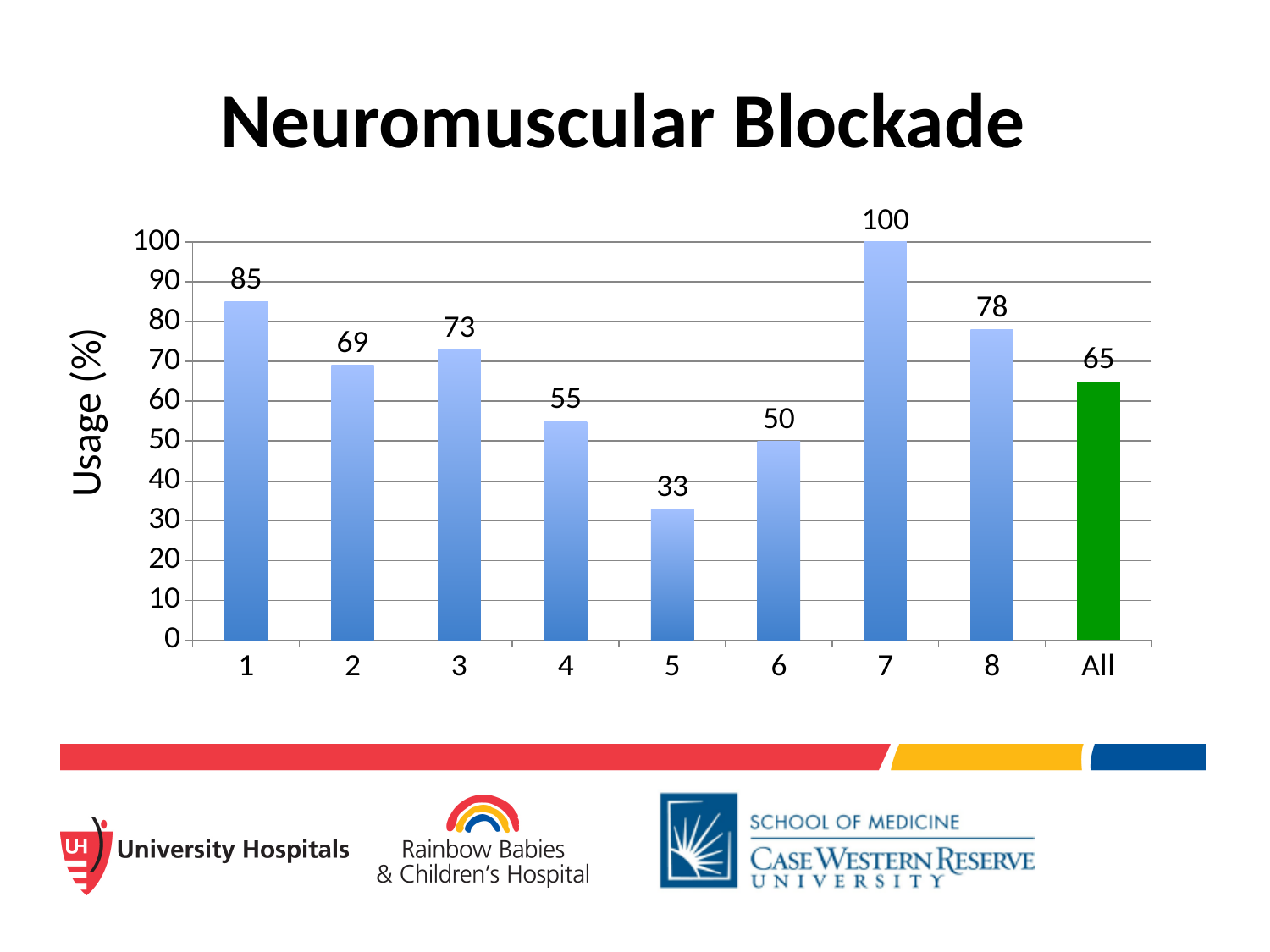
What is the difference in usage (%) between category 1 and category 4? 30 How many categories are shown on the x axis? 9 What is the difference in usage (%) between category 7 and category 8? 22 Which category has the highest usage (%)? 7 What is the usage (%) value for category 5? 33 Which has a higher usage (%), category 2 or category 3? 3 What is the usage (%) value for category 1? 85 Which category has the lowest usage (%)? 5 What is the usage (%) value for the 'All' category? 65 Is the value for category 6 greater or less than 60? less What is the title of the slide containing the chart? Neuromuscular Blockade What kind of chart is shown on the slide? bar chart